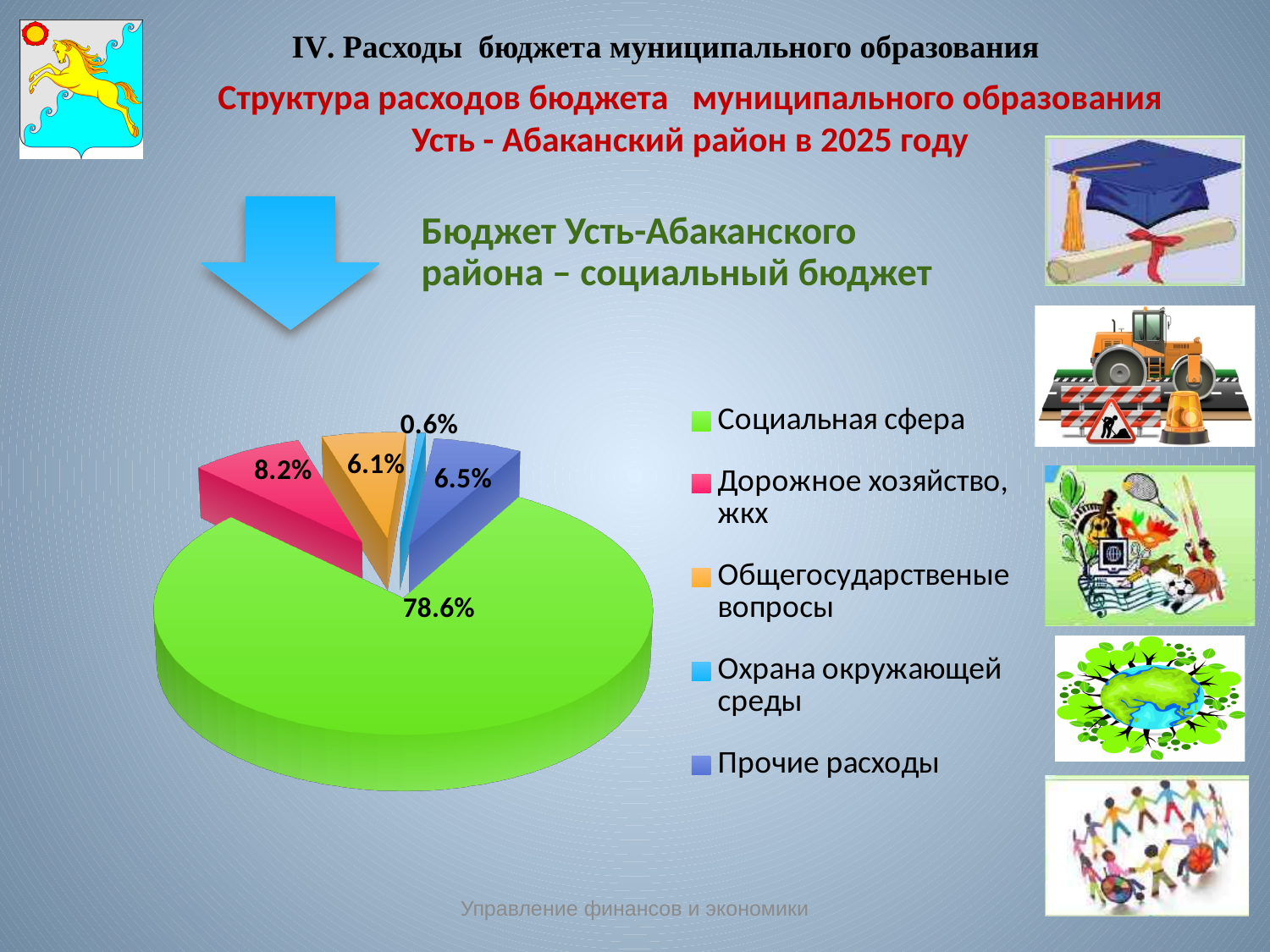
What share of the budget expenditure goes to Дорожное хозяйство, жкх? 8.2% What kind of chart is shown on the slide? pie chart Which category has the smallest share of the pie? Охрана окружающей среды Which is larger: the share of Прочие расходы or the share of Общегосударственые вопросы? Прочие расходы What share of the budget expenditure goes to Общегосударственые вопросы? 6.1% Which category has the largest share of the pie? Социальная сфера What share of the budget expenditure goes to Прочие расходы? 6.5% How many categories does the pie chart show? 5 What share of the budget expenditure goes to Социальная сфера? 78.6% What colour is the slice for Социальная сфера? green What is the difference between the shares of Дорожное хозяйство, жкх and Прочие расходы? 1.7% What share of the budget expenditure goes to Охрана окружающей среды? 0.6%